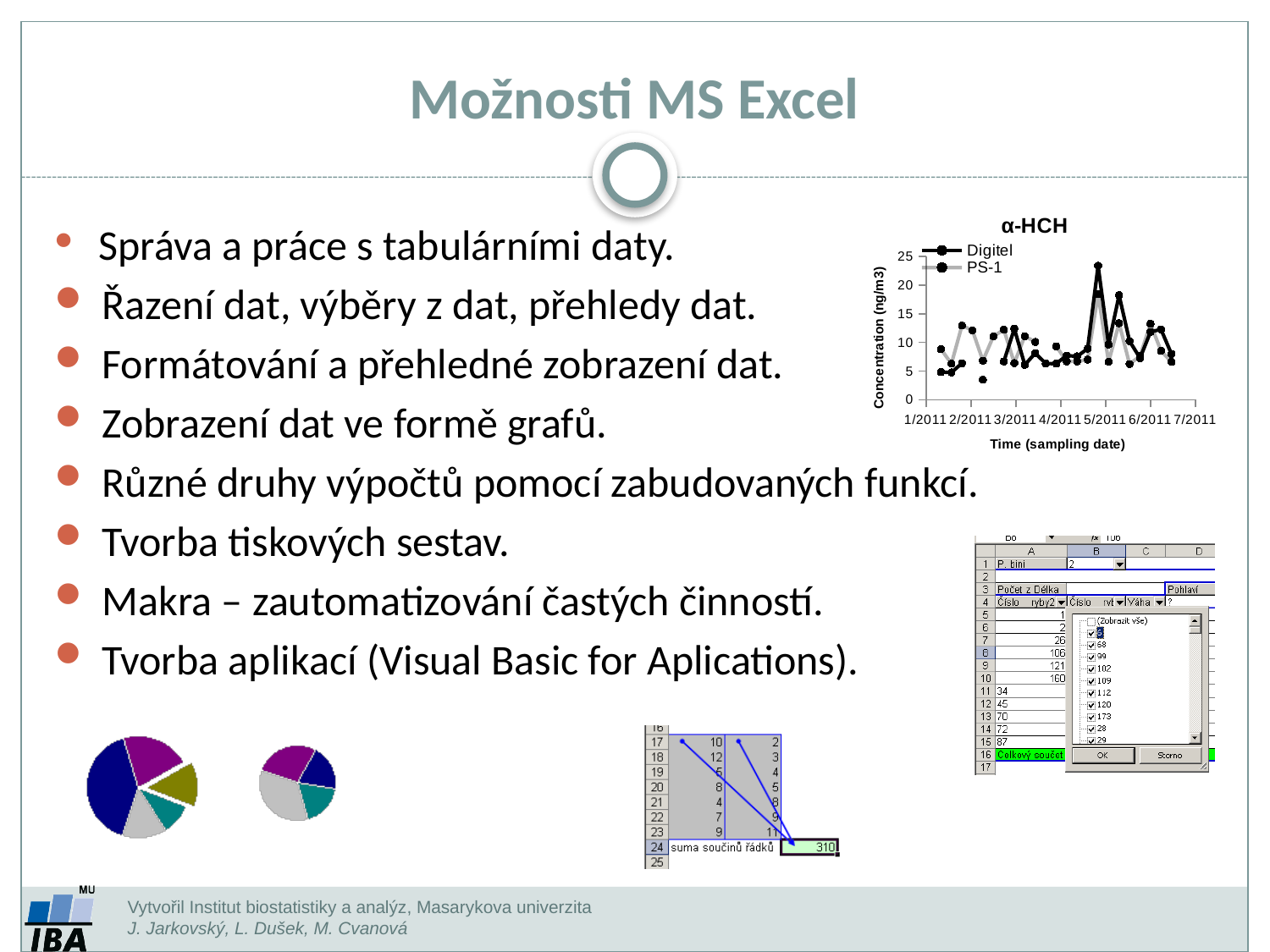
What kind of chart is the α-HCH chart? line chart In the α-HCH chart, is the highest value of the Digitel series greater or less than 25? less What are the two series named in the legend of the α-HCH chart? Digitel and PS-1 In the α-HCH chart, is the first Digitel value at 1/2011 greater or less than 10? less In the α-HCH chart, is the highest value of the Digitel series greater or less than 20? greater How many series does the legend of the α-HCH chart list? 2 What kind of charts are the two small charts in the bottom-left corner of the slide? pie charts In the α-HCH chart, around which month label does the Digitel series reach its highest peak? 5/2011 What is the title of the line chart on the slide? α-HCH How many date labels are shown on the x axis of the α-HCH chart? 7